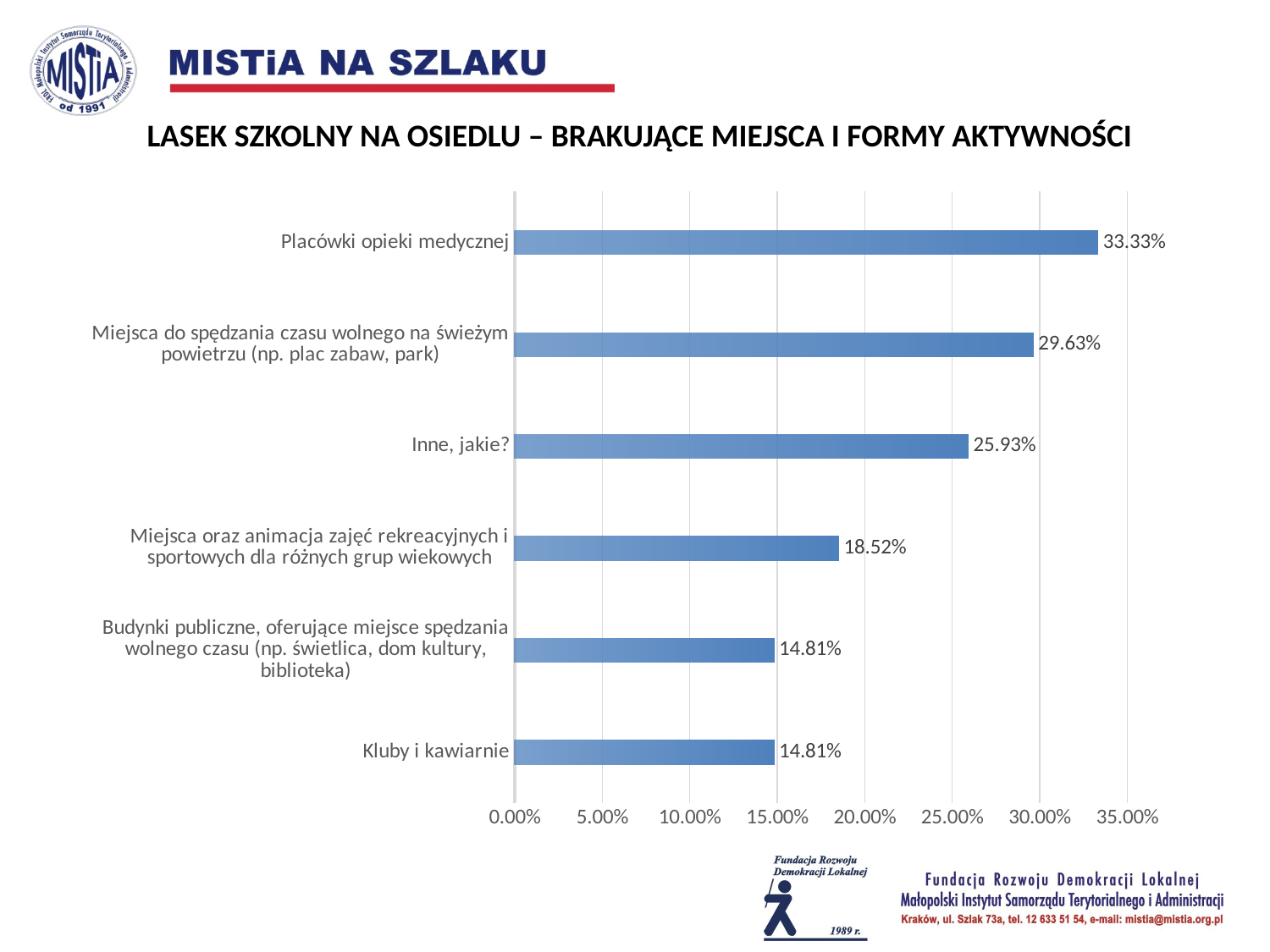
What is the difference between the values for Miejsca do spędzania czasu wolnego na świeżym powietrzu (np. plac zabaw, park) and Kluby i kawiarnie? 14.82% How many categories are shown in the chart? 6 Is the value for Miejsca do spędzania czasu wolnego na świeżym powietrzu (np. plac zabaw, park) greater or less than 25.00%? greater What is the value for Kluby i kawiarnie? 14.81% Which is larger: the value for Inne, jakie? or the value for Miejsca oraz animacja zajęć rekreacyjnych i sportowych dla różnych grup wiekowych? Inne, jakie? What is the value for Miejsca oraz animacja zajęć rekreacyjnych i sportowych dla różnych grup wiekowych? 18.52% What is the title of the slide above the chart? LASEK SZKOLNY NA OSIEDLU – BRAKUJĄCE MIEJSCA I FORMY AKTYWNOŚCI What is the value for Inne, jakie?? 25.93% What kind of chart is shown on the slide? bar chart What is the value for Placówki opieki medycznej? 33.33% What is the difference between the values for Placówki opieki medycznej and Inne, jakie?? 7.40% Which category has the highest value? Placówki opieki medycznej